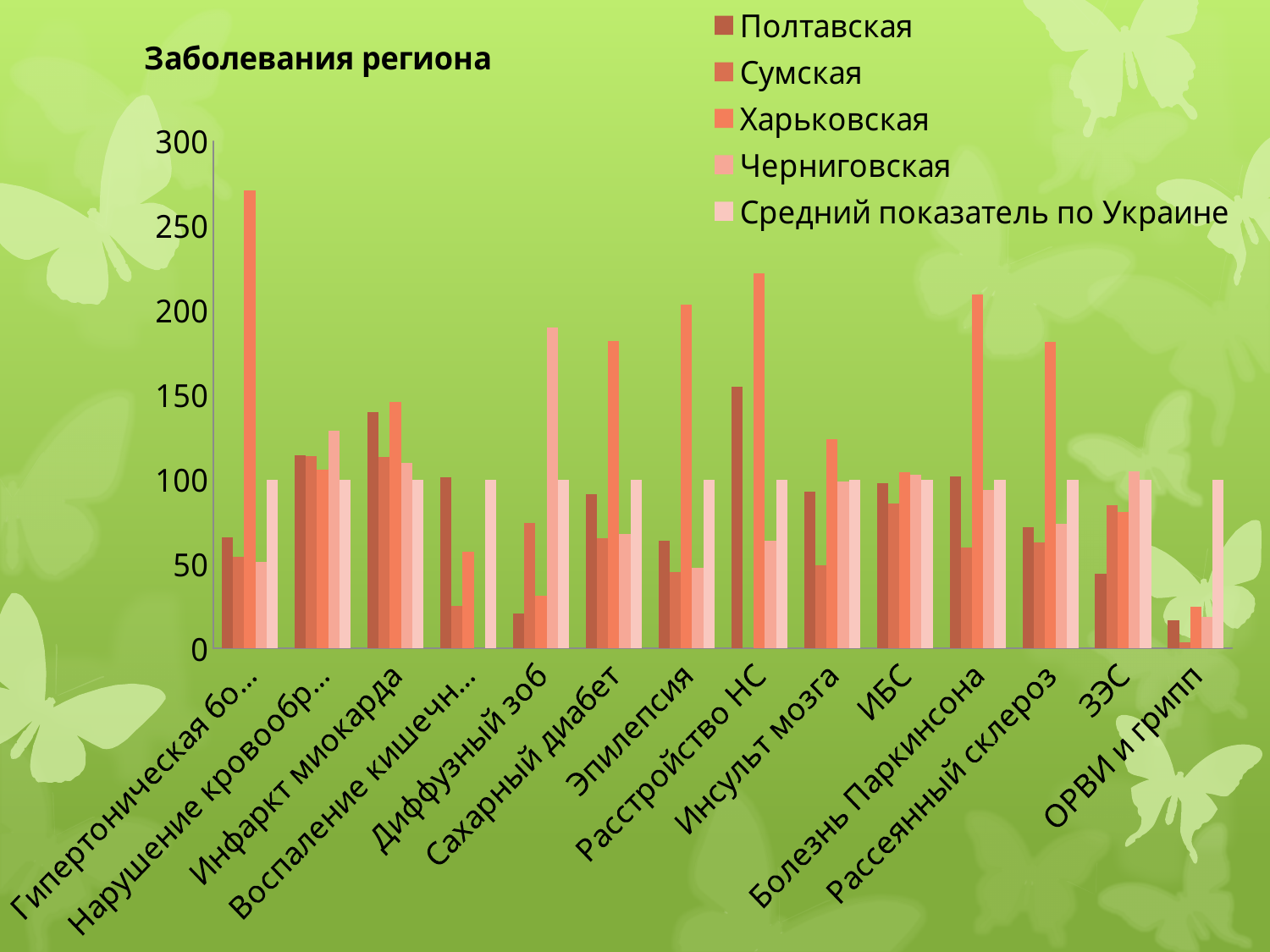
How many disease categories are shown on the x axis? 14 Is the value for Харьковская in the Расстройство НС category greater or less than 200? greater Is the value for Харьковская in the Гипертоническая бо... category greater or less than 250? greater Which region has the highest value in the Гипертоническая бо... category? Харьковская How many series does the legend list? 5 What is the title of the chart? Заболевания региона In the Расстройство НС category, which is larger: the value for Полтавская or for Харьковская? Харьковская Is the value for Харьковская in the Болезнь Паркинсона category greater or less than 200? greater What kind of chart is shown on the slide? bar chart